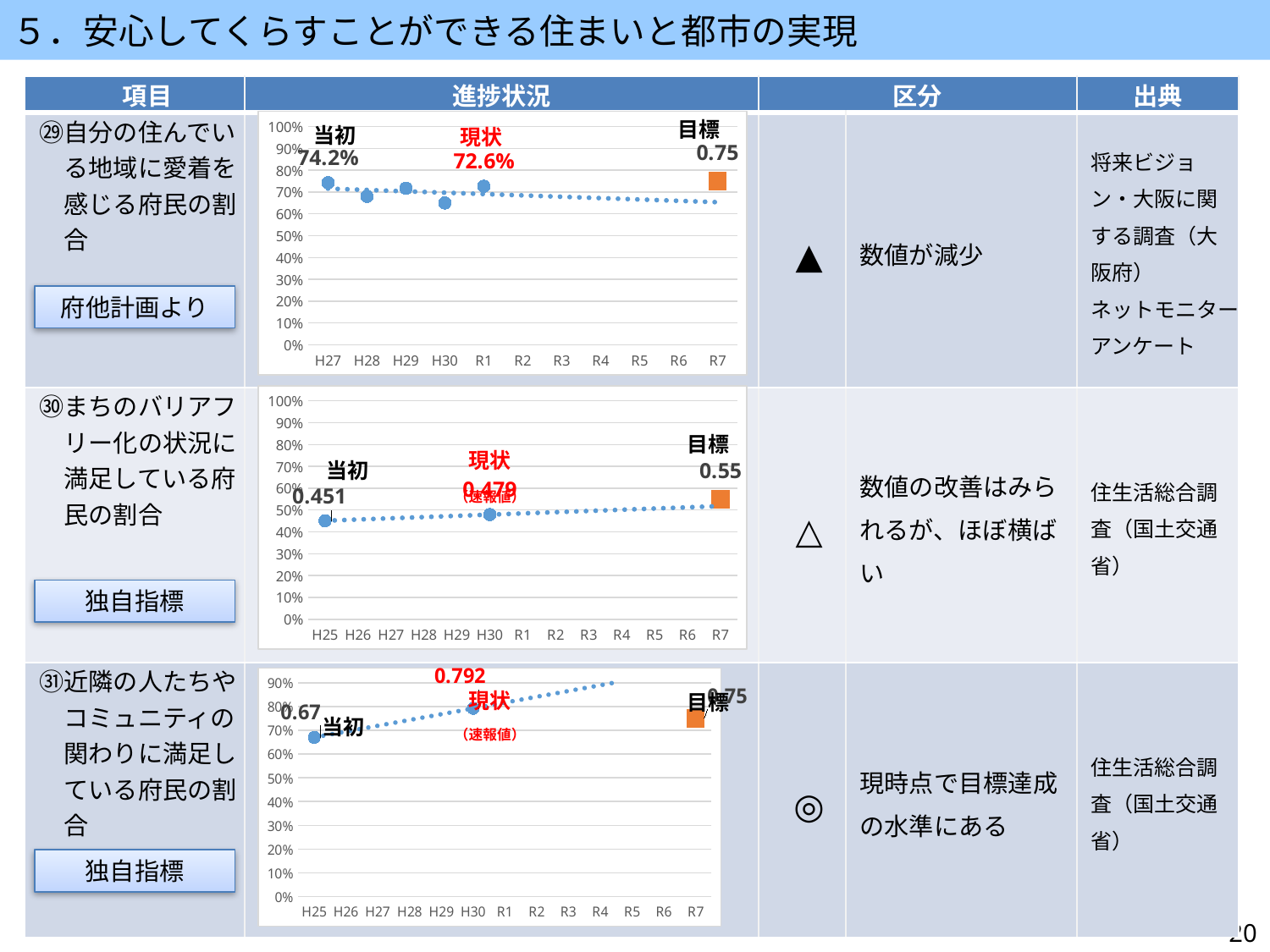
In the middle chart (item ㉚), what is the 現状 (current) value? 0.479 In the bottom chart (item ㉛, 近隣の人たちやコミュニティの関わりに満足している府民の割合), what is the 現状 (current) value? 0.792 In the top chart (item ㉙), what is the 目標 (target) value? 0.75 In the top chart (item ㉙, 自分の住んでいる地域に愛着を感じる府民の割合), what is the 当初 (initial) value? 74.2% In the middle chart (item ㉚), what is the difference between the 目標 (target) value and the 当初 (initial) value? 0.099 In the bottom chart (item ㉛), do the plotted values rise or fall from 当初 to 現状? rise In the top chart (item ㉙), is the value for H30 greater or less than 70%? less In the top chart (item ㉙), what is the 現状 (current) value? 72.6% In the middle chart (item ㉚, まちのバリアフリー化の状況に満足している府民の割合), what is the 当初 (initial) value? 0.451 In the top chart (item ㉙), how many categories are shown on the x axis? 11 What kind of chart is the bottom chart (item ㉛)? line chart In the bottom chart (item ㉛), which is larger, the 現状 (current) value or the 目標 (target) value? 現状 (current)